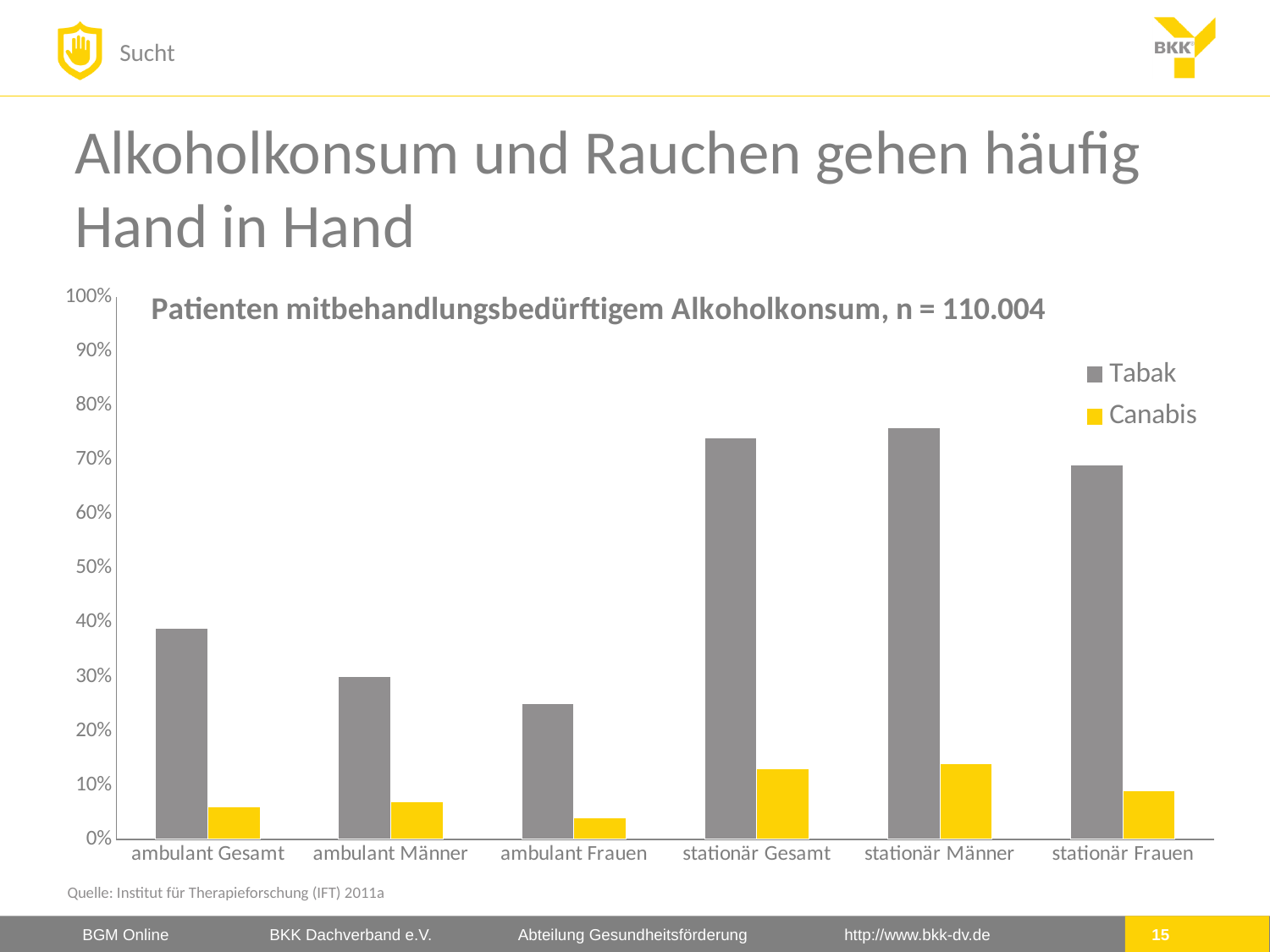
Is the Canabis value for stationär Gesamt greater or less than 10%? greater Which category has the lowest Canabis value? ambulant Frauen How many series does the chart legend list? 2 Which category has the lowest Tabak value? ambulant Frauen Is the Tabak value for ambulant Gesamt greater or less than 30%? greater Which colour represents the Canabis series in the chart? yellow Is the Tabak value for ambulant Frauen greater or less than 30%? less Which is larger for stationär Frauen, the Tabak value or the Canabis value? Tabak How many categories are shown along the x axis of the chart? 6 What kind of chart is shown on the slide? bar chart